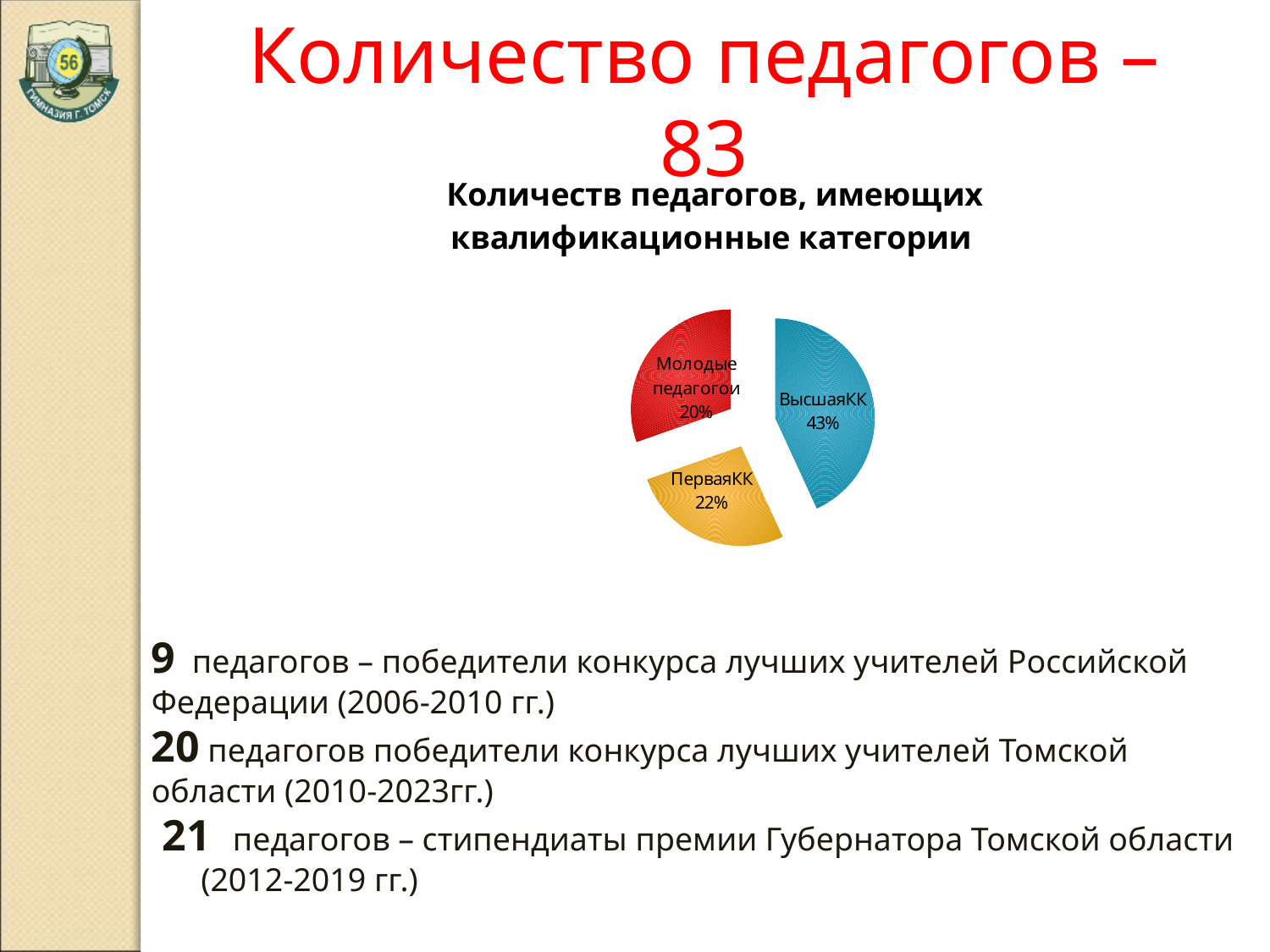
What share of the pie does Молодые педагоги have? 20% What colour is the ПерваяКК slice? yellow What kind of chart is shown on the slide? pie chart How many slices does the pie chart have? 3 What is the difference in percentage points between ВысшаяКК and ПерваяКК? 21 What share of the pie does ПерваяКК have? 22% Which slice of the pie is the largest? ВысшаяКК What is the title of the chart? Количеств педагогов, имеющих квалификационные категории Which is larger, the share for ВысшаяКК or the share for Молодые педагоги? ВысшаяКК What is the difference in percentage points between ПерваяКК and Молодые педагоги? 2 What share of the pie does ВысшаяКК have? 43%